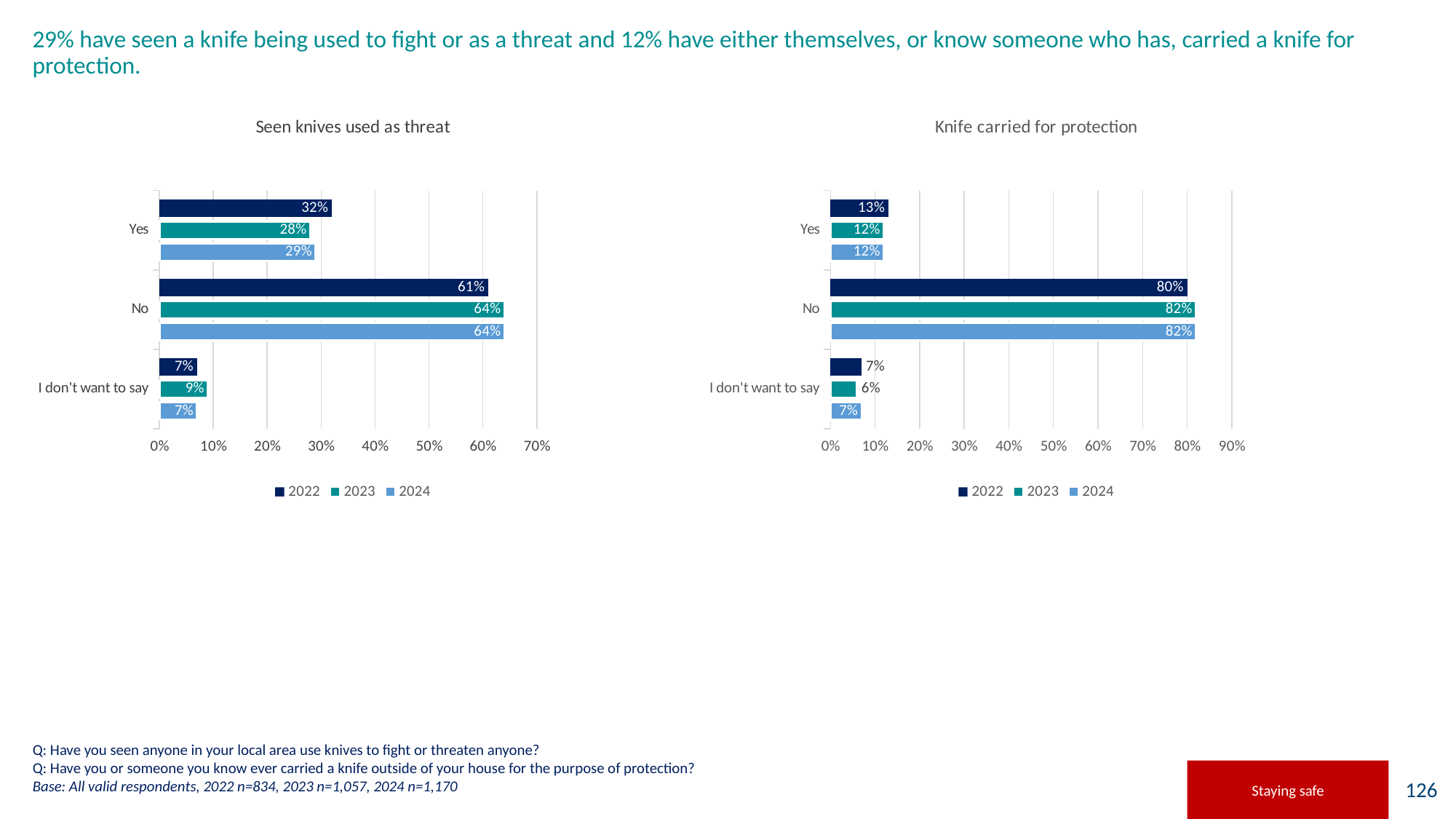
In the 'Seen knives used as threat' chart, which category has the highest 2023 value? No In the 'Knife carried for protection' chart, what is the 2023 value for I don't want to say? 6% In the 'Seen knives used as threat' chart, what is the 2024 value for Yes? 29% In the 'Knife carried for protection' chart, what is the difference between the 2023 and 2022 values for No? 2% In the 'Knife carried for protection' chart, what is the 2022 value for Yes? 13% How many categories are shown in the 'Seen knives used as threat' chart? 3 How many series does the legend of the 'Knife carried for protection' chart list? 3 In the 'Seen knives used as threat' chart, what is the difference between the 2022 and 2023 values for Yes? 4% What kind of chart is the 'Knife carried for protection' chart? Bar chart In the 'Knife carried for protection' chart, which category has the lowest 2024 value? I don't want to say In the 'Seen knives used as threat' chart, what is the 2022 value for No? 61% In the 'Seen knives used as threat' chart, which is larger for I don't want to say: the 2022 value or the 2023 value? 2023